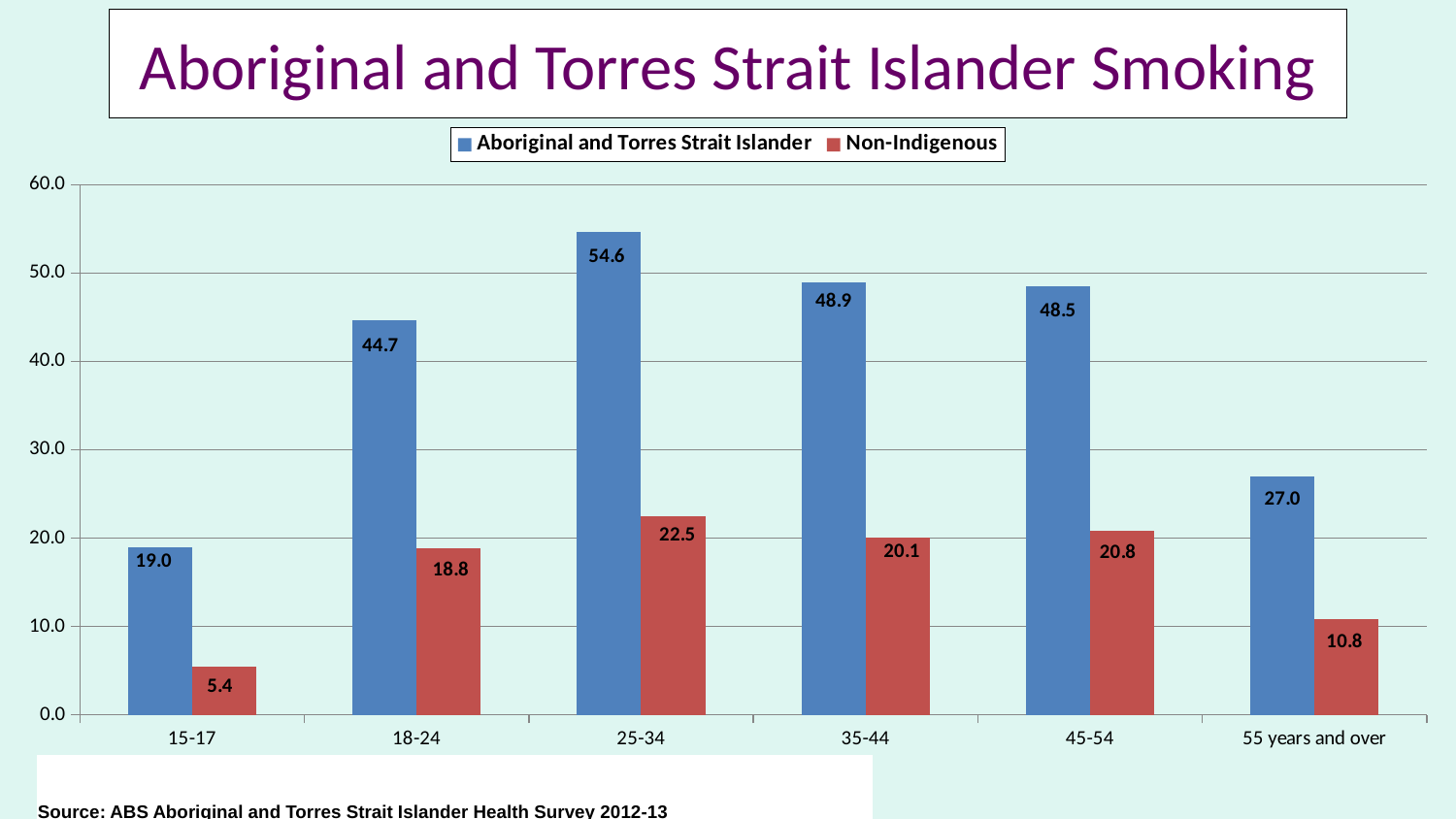
What is the value for Non-Indigenous in the 55 years and over age group? 10.8 How many age groups are shown on the x axis? 6 Which age group has the highest value for Aboriginal and Torres Strait Islander? 25-34 Which is larger: the Non-Indigenous value for 18-24 or for 45-54? 45-54 What is the difference between the Aboriginal and Torres Strait Islander and Non-Indigenous values in the 35-44 age group? 28.8 What is the value for Aboriginal and Torres Strait Islander in the 25-34 age group? 54.6 How many series does the legend list? 2 What kind of chart is shown on the slide? bar chart Is the Aboriginal and Torres Strait Islander value for 55 years and over greater or less than 30.0? less Which age group has the lowest value for Non-Indigenous? 15-17 What is the value for Non-Indigenous in the 15-17 age group? 5.4 What is the title of the chart? Aboriginal and Torres Strait Islander Smoking